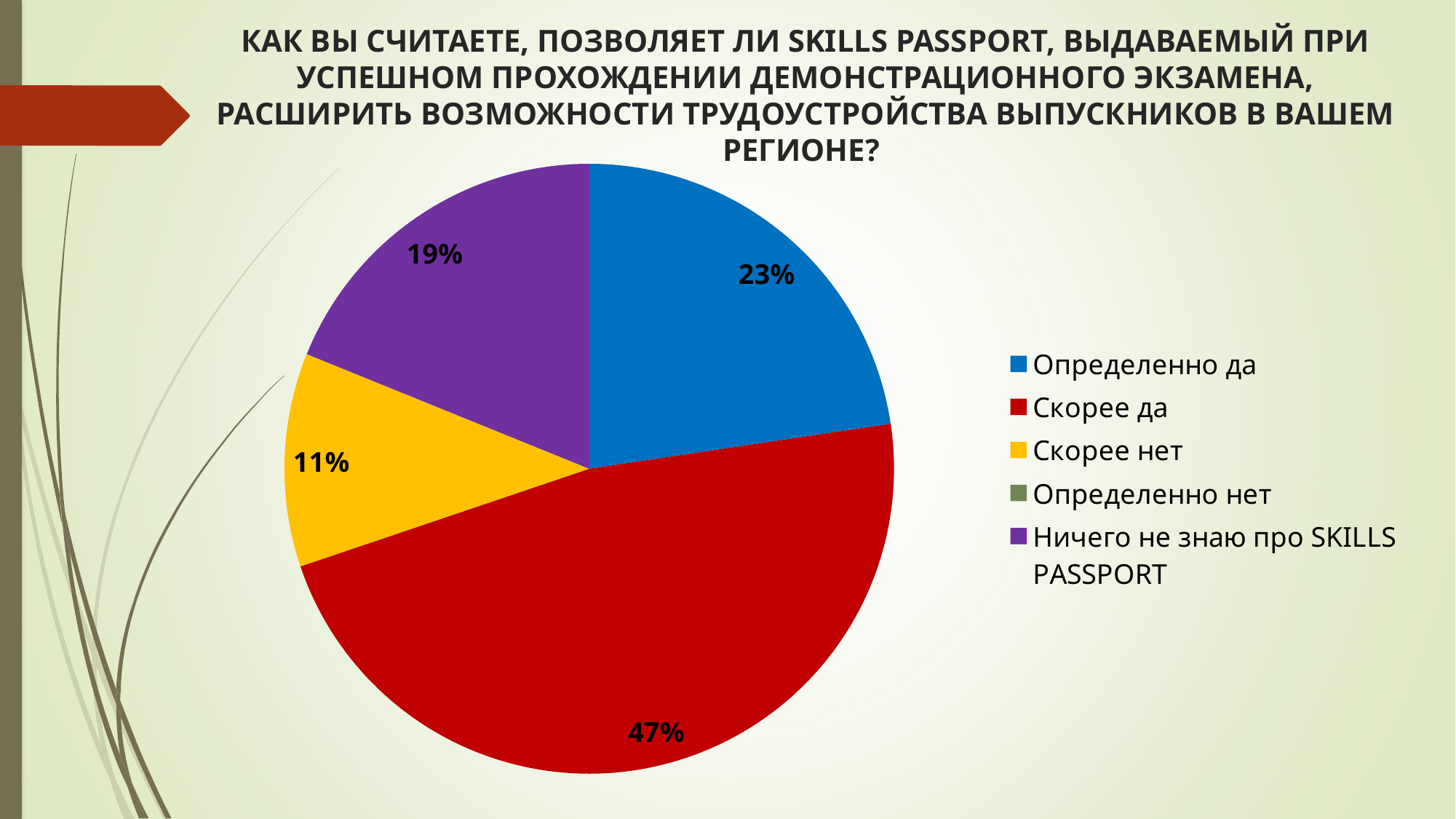
What is the difference in percentage points between "Скорее да" and "Определенно да"? 24 What percentage of respondents answered "Определенно да"? 23% Among the slices with printed labels, which answer option has the smallest share? Скорее нет What is the combined share of "Определенно да" and "Скорее да"? 70% What type of chart is shown on the slide? pie chart What percentage of respondents answered "Скорее да"? 47% How many entries does the legend list? 5 What colour is the slice for "Скорее нет"? yellow What percentage of respondents answered "Ничего не знаю про SKILLS PASSPORT"? 19% What percentage of respondents answered "Скорее нет"? 11% Which is larger: the share for "Определенно да" or the share for "Ничего не знаю про SKILLS PASSPORT"? Определенно да Which answer option has the largest share of the pie? Скорее да